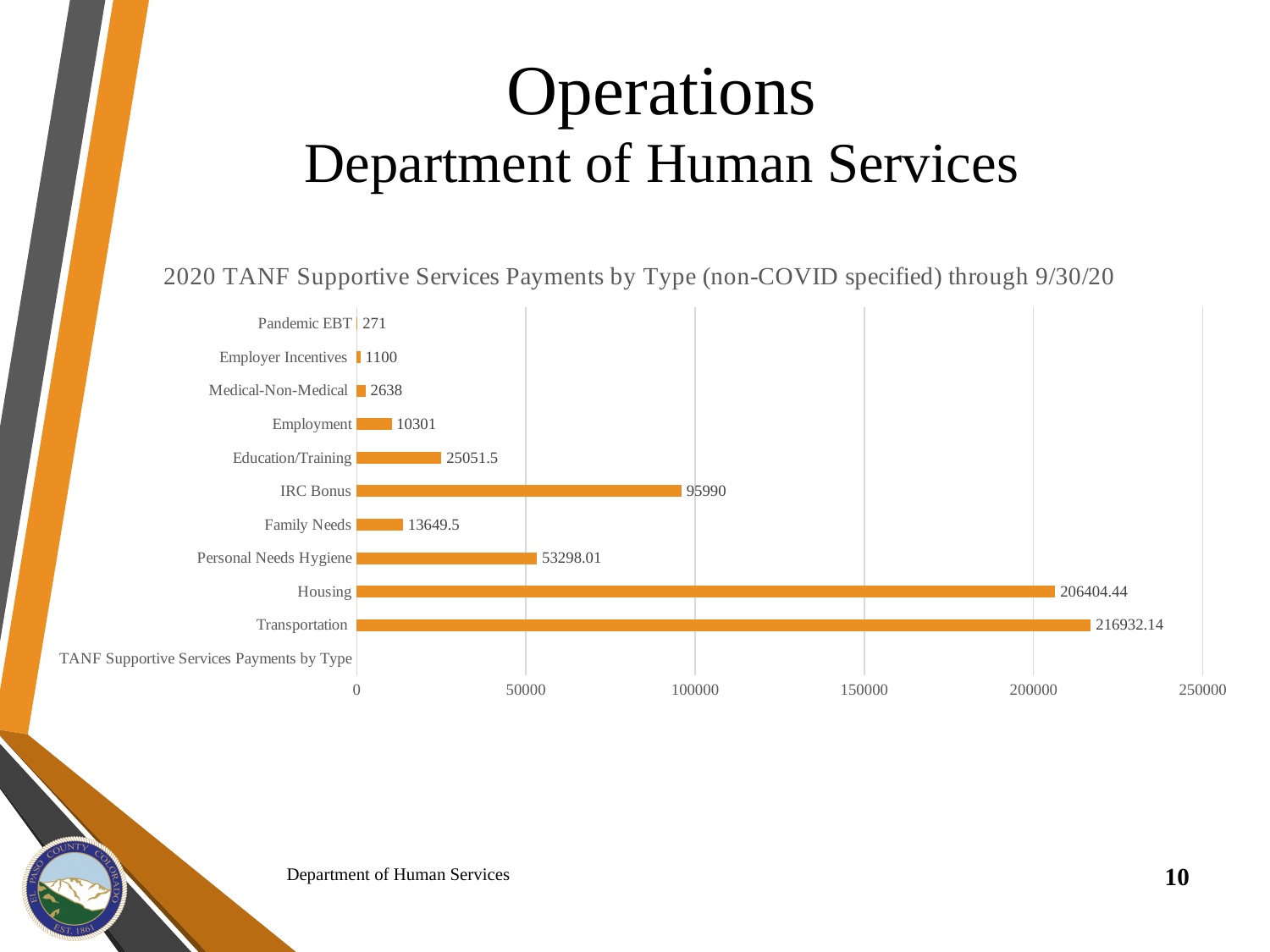
What is the title of the chart? 2020 TANF Supportive Services Payments by Type (non-COVID specified) through 9/30/20 Which category has the highest value? Transportation Is the value for Housing greater or less than 200000? greater What is the value for IRC Bonus? 95990 Which is larger, the value for Personal Needs Hygiene or the value for Family Needs? Personal Needs Hygiene What is the value for Pandemic EBT? 271 What is the difference between the values for Employment and Medical-Non-Medical? 7663 Which category has the lowest value? Pandemic EBT What kind of chart is shown on the slide? Bar chart What is the value for Transportation? 216932.14 What is the difference between the values for Transportation and Housing? 10527.7 What is the value for Education/Training? 25051.5